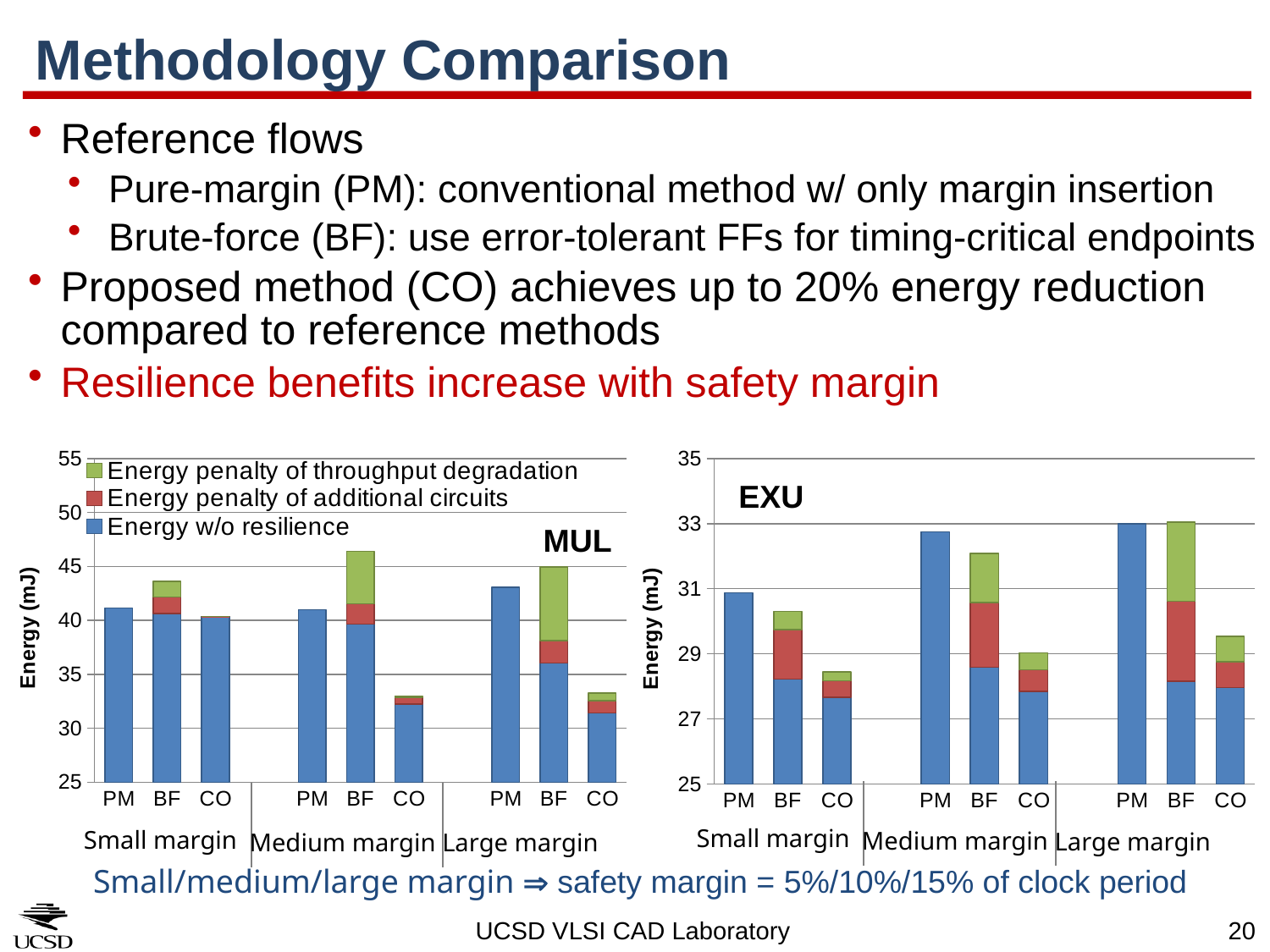
In the EXU chart, is the total for CO under Small margin greater or less than 29? less In the EXU chart, which bar has the lowest total energy? CO, Small margin How many series does the legend on the MUL chart list? 3 What kind of chart is the MUL chart? stacked bar chart How many bars are plotted in the EXU chart? 9 In the EXU chart, under Large margin, which has the larger total energy, PM or CO? PM In the MUL chart, is the total for CO under Medium margin greater or less than 35? less In the EXU chart, does the PM value rise or fall from Small margin to Large margin? rise In the MUL chart, is the total for BF under Medium margin greater or less than 45? greater In the MUL chart, under Medium margin, which has the larger total energy, PM or CO? PM In the MUL chart, which legend entry corresponds to the green segments? Energy penalty of throughput degradation